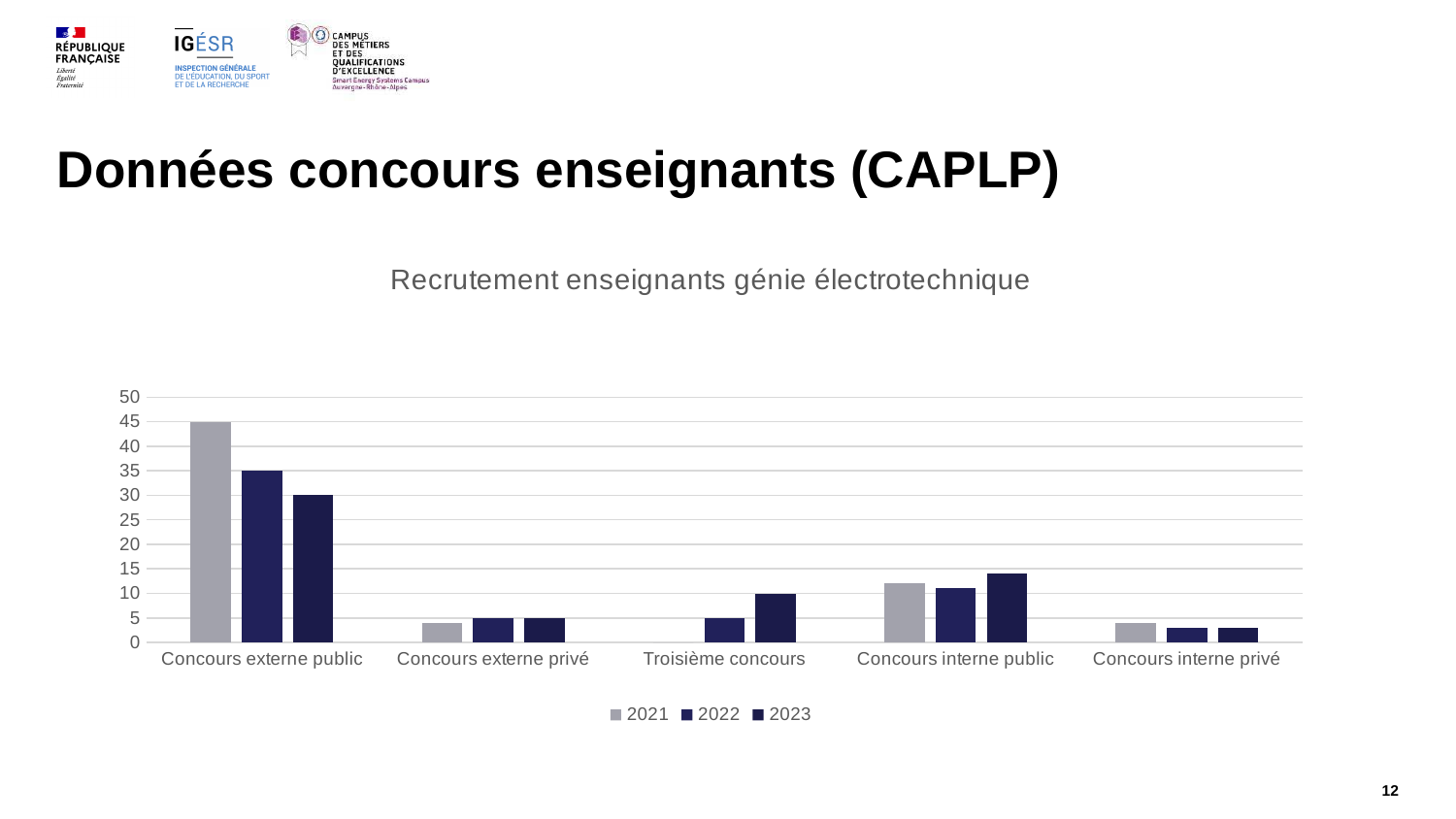
What is the value for Concours externe public in 2023? 30 How many categories are shown on the x axis? 5 Is the value for Concours interne privé in 2022 greater or less than 5? less What is the title of the chart? Recrutement enseignants génie électrotechnique What is the difference between the 2021 and 2022 values for Concours externe public? 10 Is the value for Concours interne public in 2023 greater or less than 10? greater Do the values for Concours externe public rise or fall from 2021 to 2023? fall Which category has the highest value in 2021? Concours externe public What type of chart is shown on the slide? bar chart What is the value for Troisième concours in 2023? 10 What is the value for Concours externe public in 2021? 45 How many series does the legend list? 3